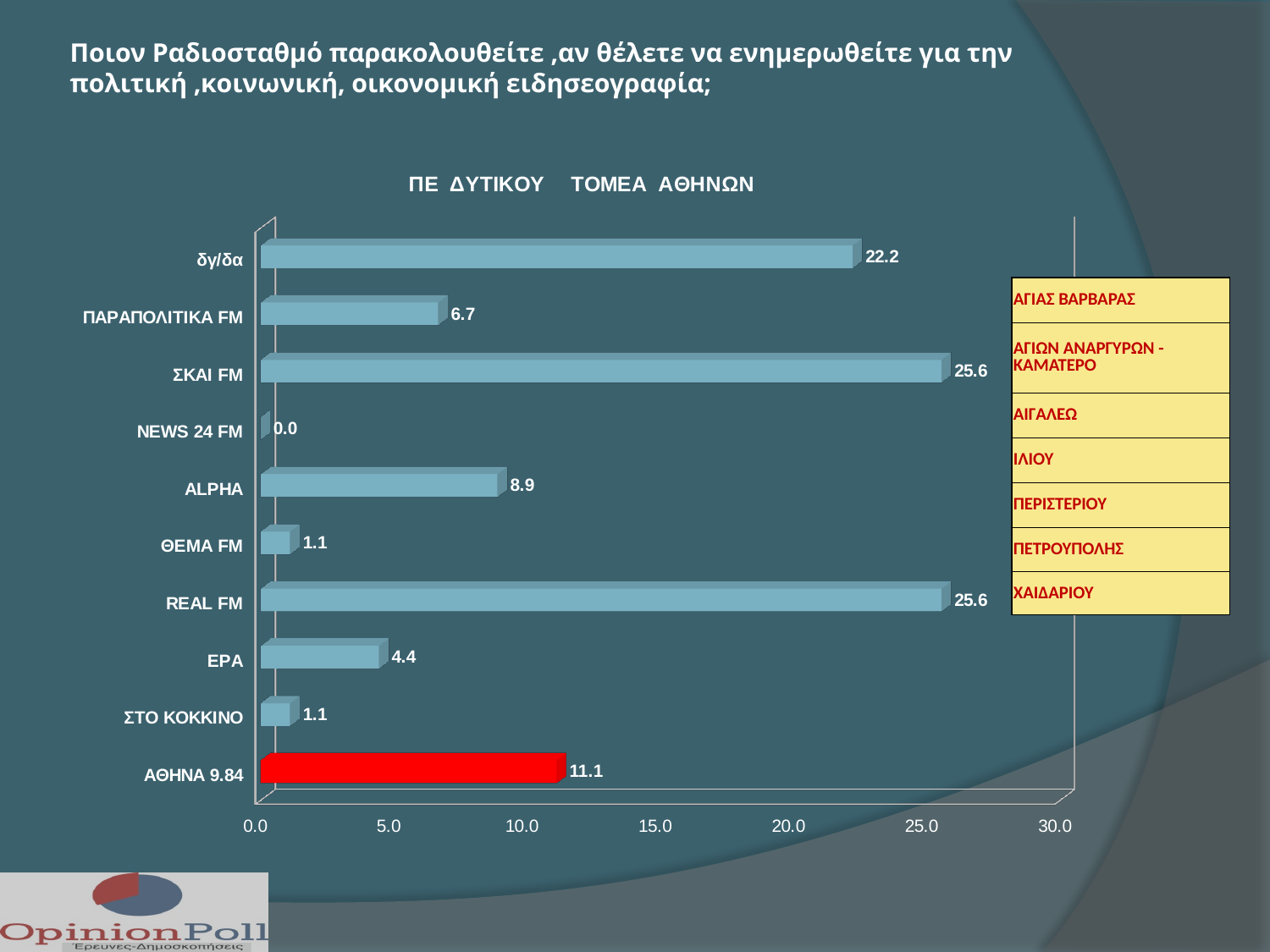
What value is shown for ΠΑΡΑΠΟΛΙΤΙΚΑ FM? 6.7 How many radio stations (categories) are shown in the chart? 10 What value is shown for ALPHA? 8.9 Which category's bar is coloured red? ΑΘΗΝΑ 9.84 What kind of chart is shown on the slide? bar chart Is the value for δγ/δα greater or less than 20.0? greater What is the difference between the values for δγ/δα and ΑΘΗΝΑ 9.84? 11.1 What value is shown for ΣΚΑΙ FM? 25.6 Which radio station has the lowest value? NEWS 24 FM What is the difference between the values for ALPHA and ΕΡΑ? 4.5 Which is larger, the value for ΠΑΡΑΠΟΛΙΤΙΚΑ FM or the value for ALPHA? ALPHA What value is shown for ΑΘΗΝΑ 9.84? 11.1